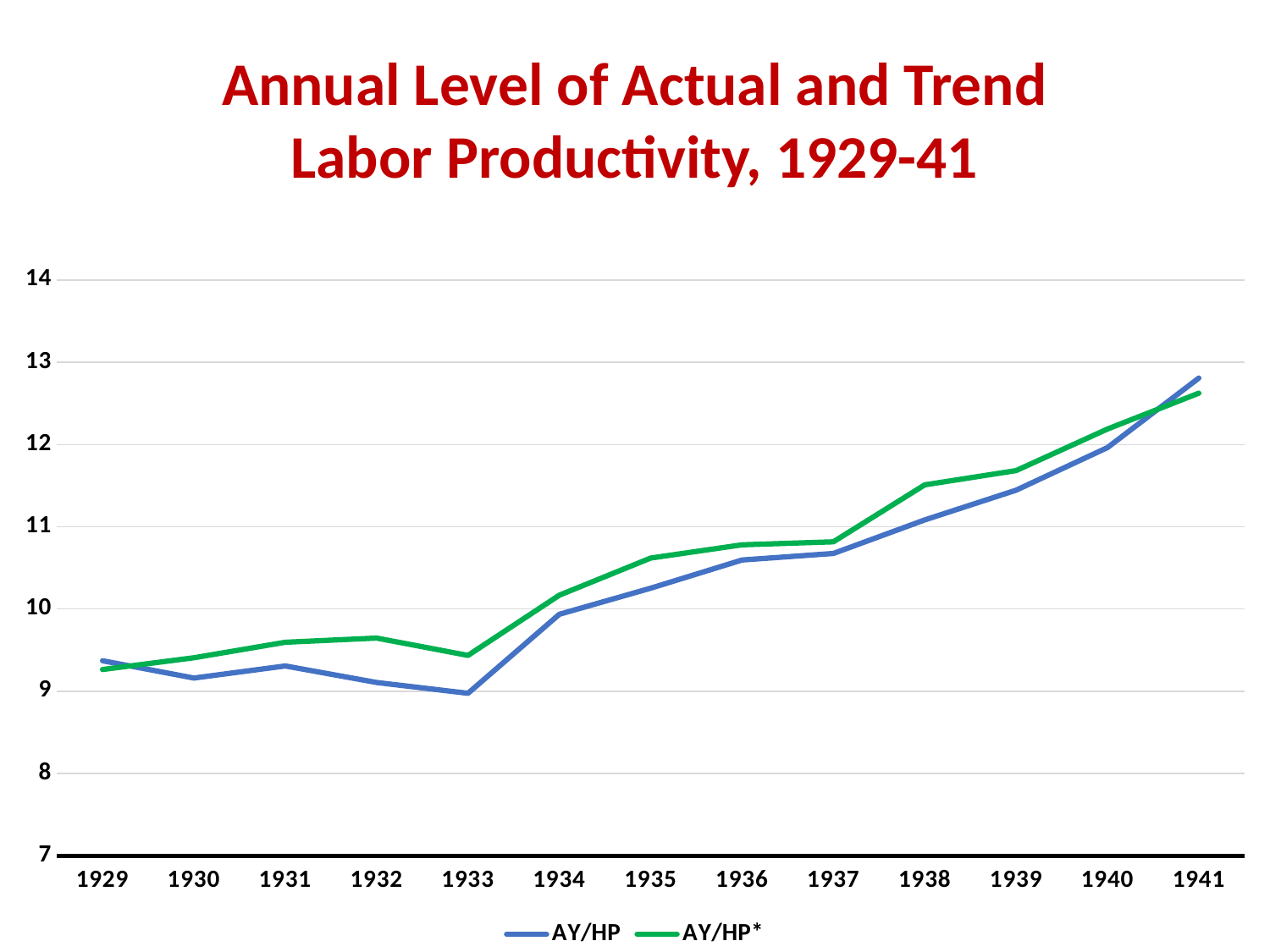
How many years are plotted along the x axis? 13 In 1938, which series has the higher value, AY/HP or AY/HP*? AY/HP* In which year is the AY/HP* series at its lowest? 1929 How many series does the legend list? 2 In which year is the AY/HP series at its lowest? 1933 In which year is the AY/HP series at its highest? 1941 Is the value for AY/HP in 1941 greater or less than 12? greater Which series is drawn in green? AY/HP* Is the value for AY/HP* in 1938 greater or less than 11? greater What kind of chart is shown on the slide? Line chart What is the title of the chart? Annual Level of Actual and Trend Labor Productivity, 1929-41 Is the value for AY/HP in 1929 greater or less than 10? less